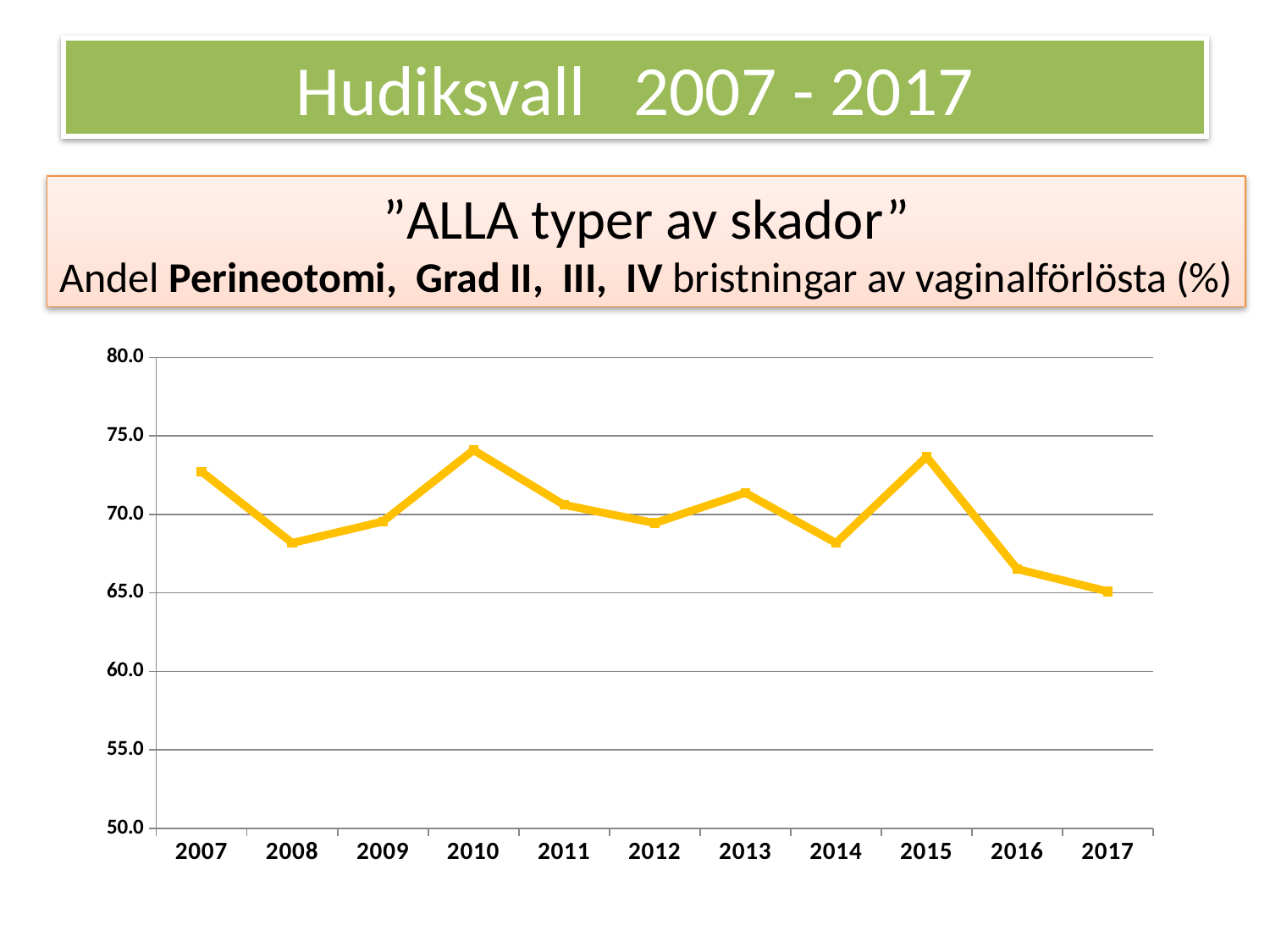
Is the value for 2016 greater or less than 70? less What kind of chart is shown on the slide? line chart Is the value for 2008 greater or less than 70? less Is the value for 2010 greater or less than 70? greater Overall, do the values rise or fall from 2007 to 2017? fall How many years are plotted on the x axis of the chart? 11 What is the lowest value shown on the y axis of the chart? 50.0 Which is larger, the value for 2007 or the value for 2008? 2007 Which is larger, the value for 2015 or the value for 2016? 2015 Which year has the lowest value in the chart? 2017